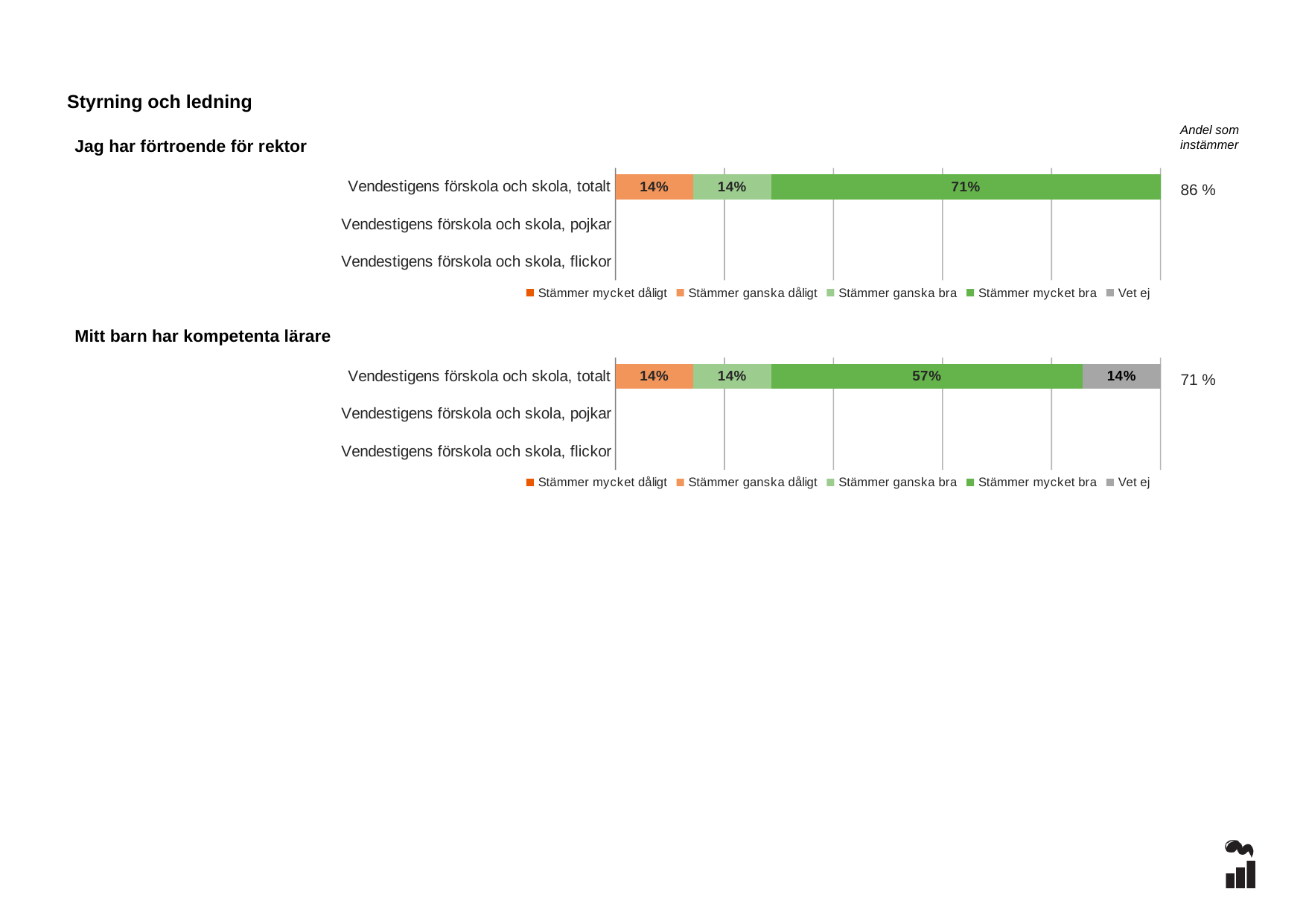
In the chart 'Jag har förtroende för rektor', what is the value of 'Stämmer ganska dåligt' for 'Vendestigens förskola och skola, totalt'? 14% How many series does the legend of the chart 'Jag har förtroende för rektor' list? 5 In the chart 'Mitt barn har kompetenta lärare', what is the value of 'Stämmer mycket bra' for 'Vendestigens förskola och skola, totalt'? 57% In the chart 'Mitt barn har kompetenta lärare', what is the value of 'Vet ej' for 'Vendestigens förskola och skola, totalt'? 14% In the chart 'Jag har förtroende för rektor', what is the 'Andel som instämmer' shown for 'Vendestigens förskola och skola, totalt'? 86 % In the chart 'Mitt barn har kompetenta lärare', what is the difference between 'Stämmer mycket bra' and 'Stämmer ganska bra' for 'Vendestigens förskola och skola, totalt'? 43% In the chart 'Jag har förtroende för rektor', which response category has the largest share for 'Vendestigens förskola och skola, totalt'? Stämmer mycket bra In the chart 'Mitt barn har kompetenta lärare', what is the 'Andel som instämmer' shown for 'Vendestigens förskola och skola, totalt'? 71 % What kind of chart is 'Mitt barn har kompetenta lärare'? Stacked bar chart In the chart 'Jag har förtroende för rektor', what is the value of 'Stämmer mycket bra' for 'Vendestigens förskola och skola, totalt'? 71% How many categories are shown on the y axis of the chart 'Mitt barn har kompetenta lärare'? 3 Is the 'Stämmer mycket bra' value for 'Vendestigens förskola och skola, totalt' larger in the chart 'Jag har förtroende för rektor' or in the chart 'Mitt barn har kompetenta lärare'? Jag har förtroende för rektor